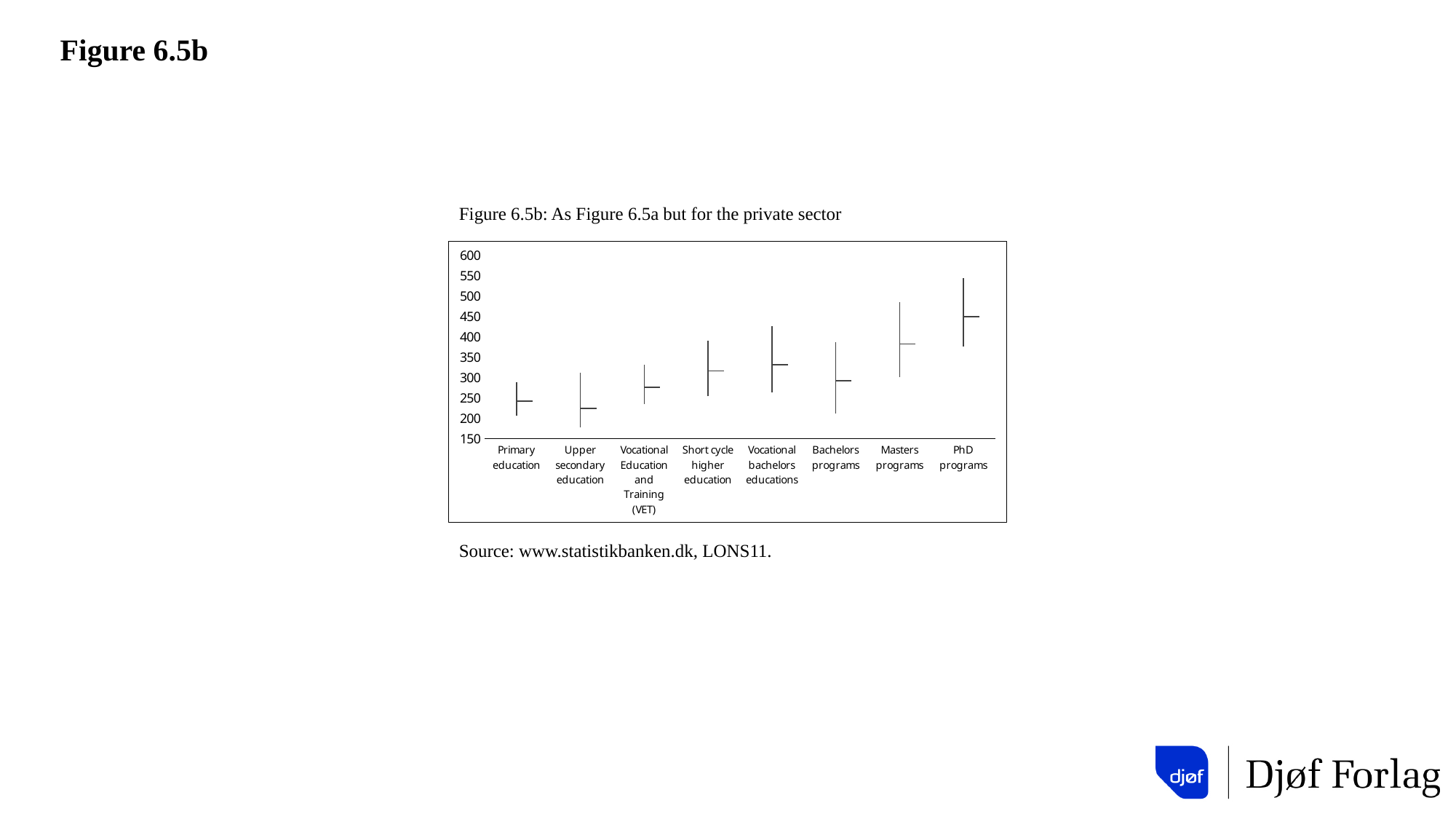
Is the bottom of the range for Bachelors programs greater or less than 250? less Is the top of the range for Masters programs greater or less than 450? greater Is the marker value for Primary education greater or less than 300? less Which has the larger marker value, Short cycle higher education or Primary education? Short cycle higher education How many education categories are shown on the x axis of the chart? 8 What is the caption of the figure shown on the slide? Figure 6.5b: As Figure 6.5a but for the private sector Which category has the highest marker value in the chart? PhD programs Which category reaches the highest top of its range in the chart? PhD programs What kind of chart is shown on the slide? A high-low (stock-style) chart with a marker for each category Which has the larger marker value, Masters programs or Bachelors programs? Masters programs Do the marker values generally rise or fall from Primary education to PhD programs along the x axis? rise